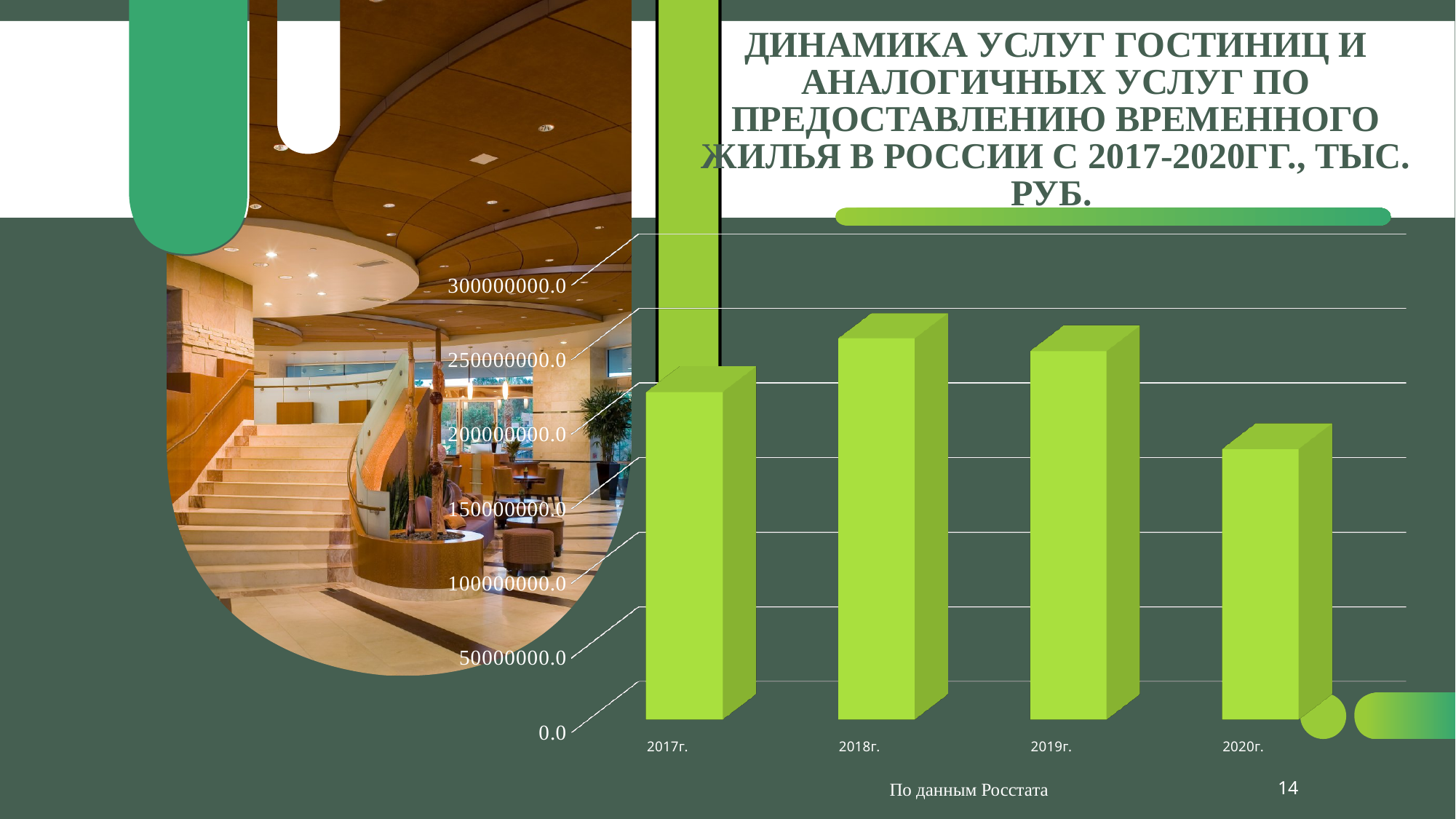
Which is larger, the value for 2018г. or the value for 2019г.? 2018г. What kind of chart is shown on the slide? bar chart Does the value rise or fall from 2019г. to 2020г.? fall Is the value for 2019г. greater or less than 200000000.0? greater Is the value for 2020г. greater or less than 200000000.0? less Is the value for 2017г. greater or less than 150000000.0? greater According to the note under the chart, what is the data source? По данным Росстата Which is larger, the value for 2017г. or the value for 2019г.? 2019г. Which year has the lowest bar on the chart? 2020г. Which year has the highest bar on the chart? 2018г. How many years (categories) are plotted on the chart? 4